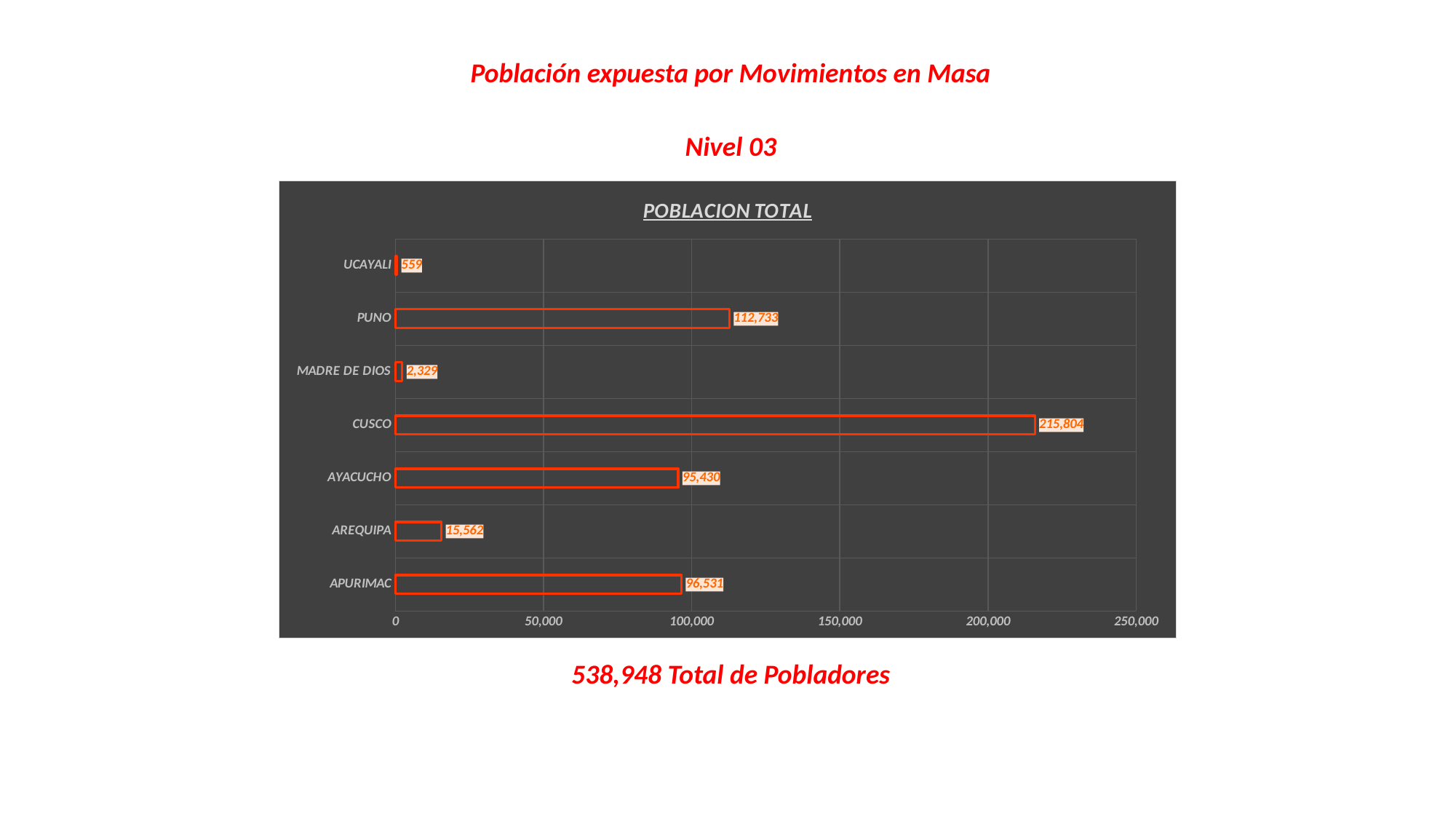
Which category has the lowest value? UCAYALI What is the value for MADRE DE DIOS? 2,329 What is the value for CUSCO? 215,804 What is the title of the chart? POBLACION TOTAL How many categories are shown in the chart? 7 Is the value for PUNO greater or less than 100,000? greater What is the value for PUNO? 112,733 What is the difference between the values for CUSCO and PUNO? 103,071 Which is larger, the value for AYACUCHO or the value for AREQUIPA? AYACUCHO What is the value for AREQUIPA? 15,562 Which category has the highest value? CUSCO What kind of chart is shown? bar chart